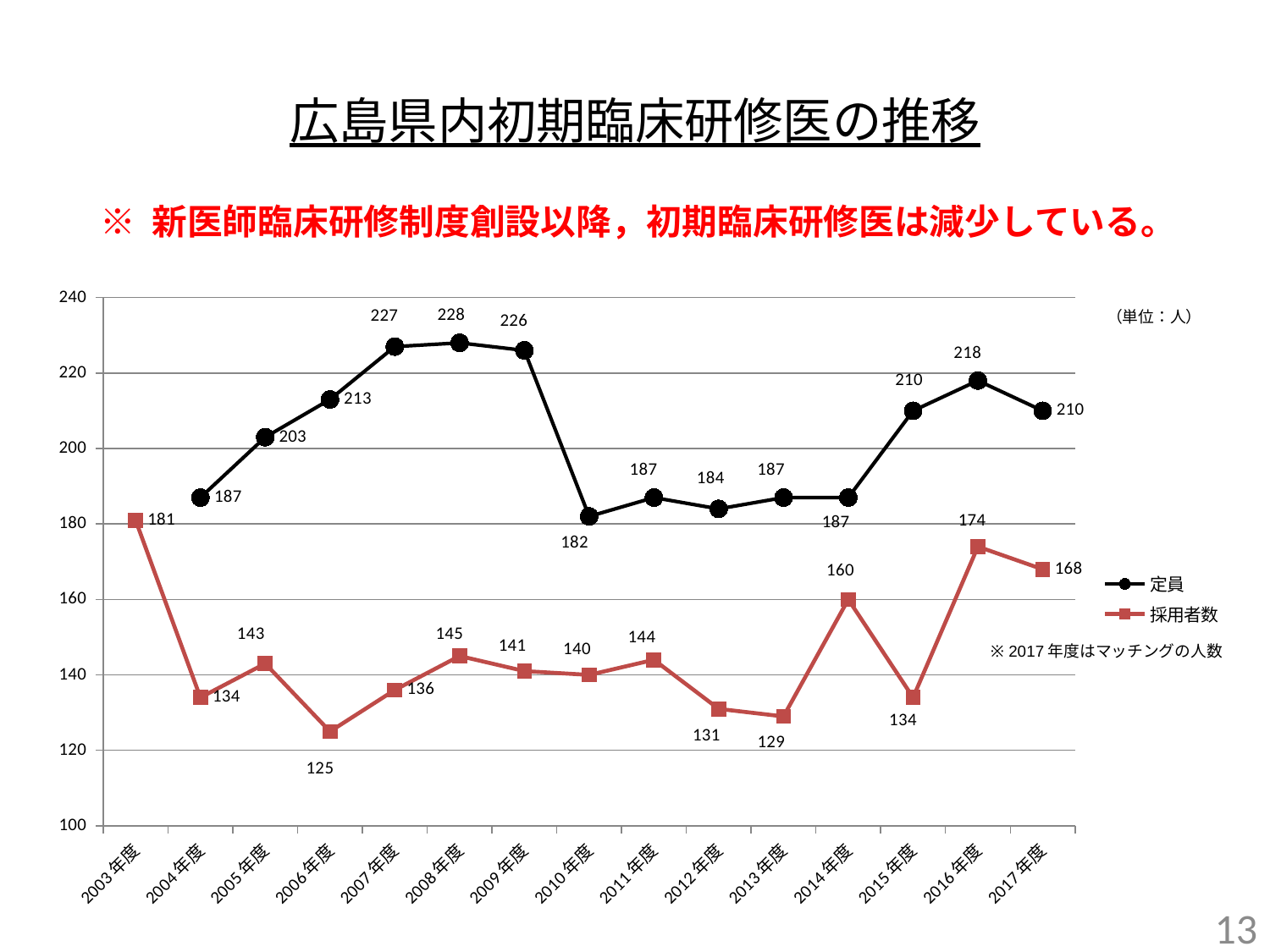
What is the value of 採用者数 for 2016年度? 174 Does 定員 rise or fall from 2009年度 to 2010年度? fall In which year is 定員 highest? 2008年度 Which is larger, 採用者数 in 2014年度 or 採用者数 in 2015年度? 2014年度 What is the difference between 定員 and 採用者数 in 2017年度? 42 How many series does the legend list? 2 What is the unit shown for the values in the chart? 人 How many fiscal years are shown on the x axis? 15 What type of chart is shown on the slide? line chart What is the value of 定員 for 2008年度? 228 In which year is 採用者数 highest? 2003年度 In which year is 採用者数 lowest? 2006年度